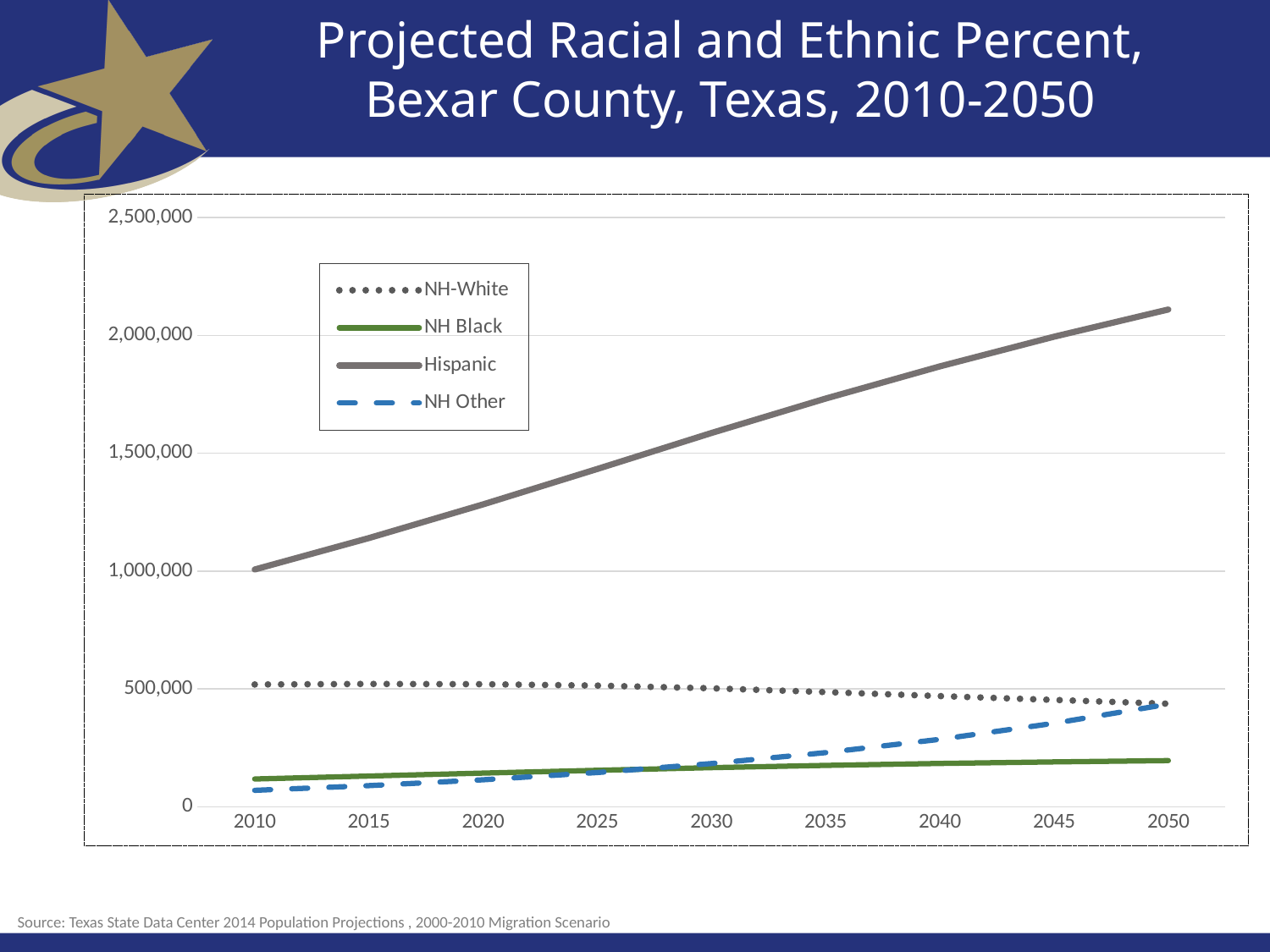
What kind of chart is shown on the slide? Line chart How many year labels are shown along the x axis? 9 Which series has the highest value in 2050? Hispanic Does the Hispanic series rise or fall from 2010 to 2050? Rise In 2050, which is larger: NH Other or NH Black? NH Other Is the value for NH Black in 2050 greater or less than 500,000? less Is the value for Hispanic in 2020 greater or less than 1,500,000? less Is the value for Hispanic in 2050 greater or less than 2,000,000? greater How many series does the legend list? 4 Which series is drawn with a dotted line in the legend? NH-White Does the NH-White series rise or fall from 2010 to 2050? Fall Which series has the lowest value in 2010? NH Other